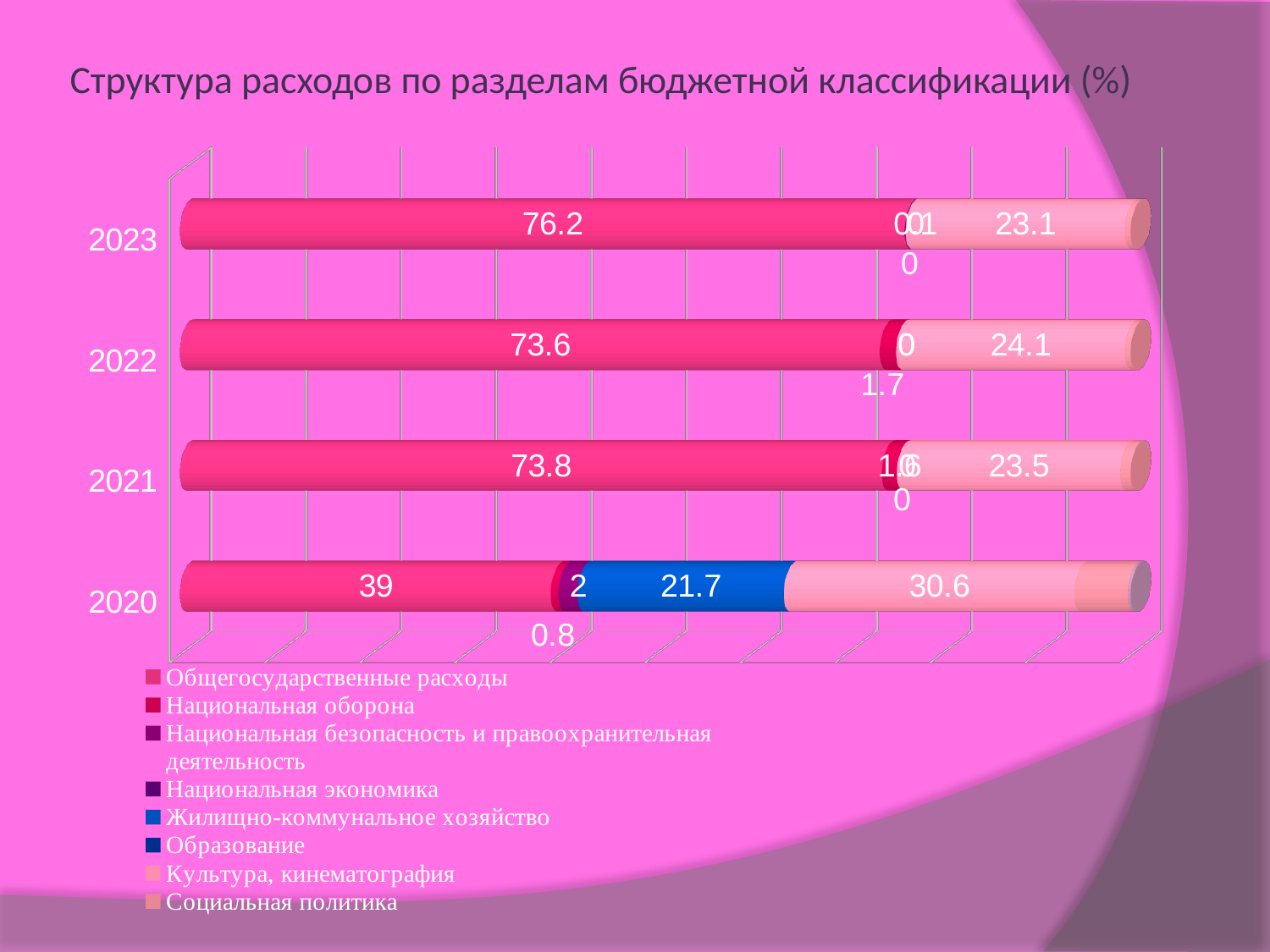
How many series does the chart legend list? 8 How many years (categories) are shown on the vertical axis of the chart? 4 What is the value of the leftmost segment of the 2020 bar? 39 What is the value of the leftmost segment of the 2021 bar? 73.8 What is the title of the chart on the slide? Структура расходов по разделам бюджетной классификации (%) What kind of chart is shown on the slide? bar chart What is the value of the leftmost segment of the 2022 bar? 73.6 What is the value of the largest (leftmost) segment of the 2023 bar? 76.2 Which year has the highest value for the leftmost segment of its bar? 2023 What is the difference between the leftmost segment values for 2023 and 2022? 2.6 What is the value of the blue segment in the 2020 bar? 21.7